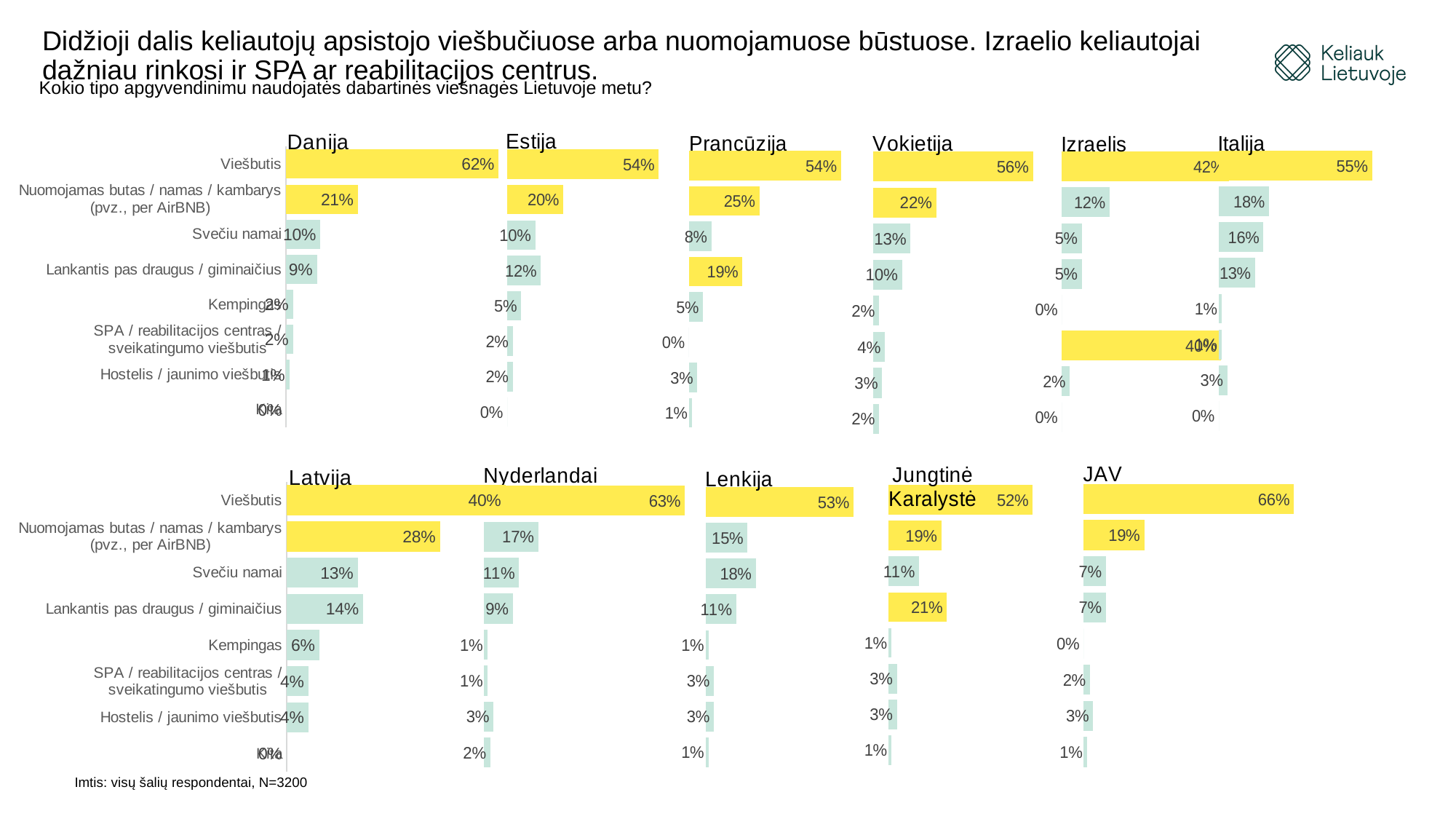
What sample size is stated at the bottom of the slide? N=3200 In the Jungtinė Karalystė chart, which category has the highest value? Viešbutis In the Danija chart, what percentage of travellers stayed in a Viešbutis? 62% In the Lenkija chart, which is larger: Svečių namai or Nuomojamas butas / namas / kambarys? Svečių namai In the Vokietija chart, what is the value for Svečių namai? 13% What type of chart is used for each country on the slide? Bar chart In the Izraelis chart, what is the value for SPA / reabilitacijos centras / sveikatingumo viešbutis? 40% In the Prancūzija chart, what is the value for Lankantis pas draugus / giminaičius? 19% In the Nyderlandai chart, what is the value for Nuomojamas butas / namas / kambarys? 17% In the Latvija chart, what is the difference between Viešbutis and Nuomojamas butas / namas / kambarys? 12% How many accommodation categories are listed in each country chart? 8 In the JAV chart, what is the value for Viešbutis? 66%